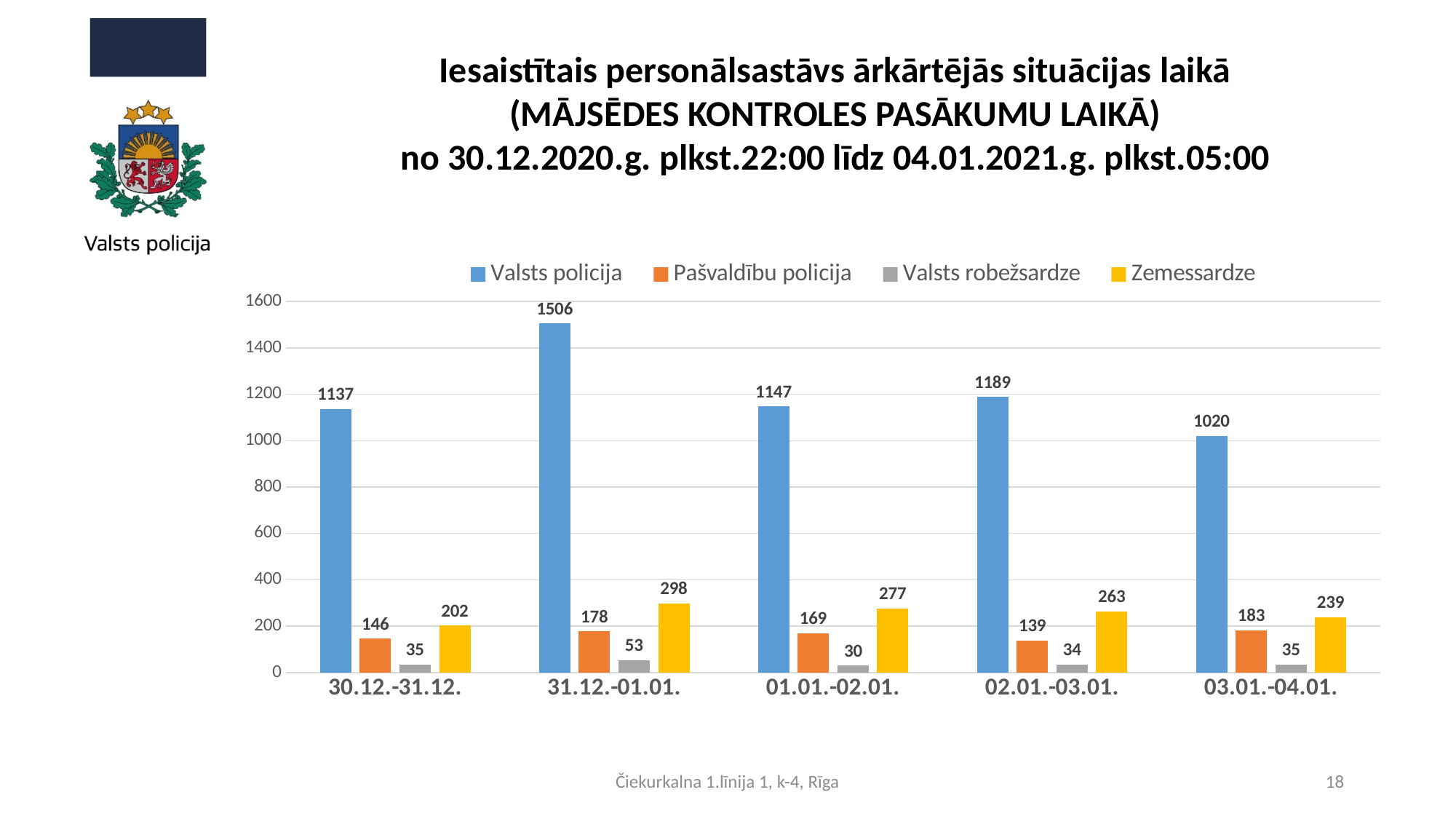
How many date periods are shown on the x axis? 5 On which date period is the Valsts policija value highest? 31.12.-01.01. Which colour represents Zemessardze in the chart? Yellow On which date period is the Zemessardze value lowest? 30.12.-31.12. What is the value for Pašvaldību policija on 02.01.-03.01.? 139 How many series does the legend list? 4 What is the value for Zemessardze on 03.01.-04.01.? 239 Which is larger: Pašvaldību policija on 31.12.-01.01. or Pašvaldību policija on 03.01.-04.01.? Pašvaldību policija on 03.01.-04.01. What kind of chart is shown on the slide? Bar chart What is the difference between the Valsts policija values for 31.12.-01.01. and 03.01.-04.01.? 486 What is the value for Valsts robežsardze on 01.01.-02.01.? 30 What is the value for Valsts policija on 31.12.-01.01.? 1506